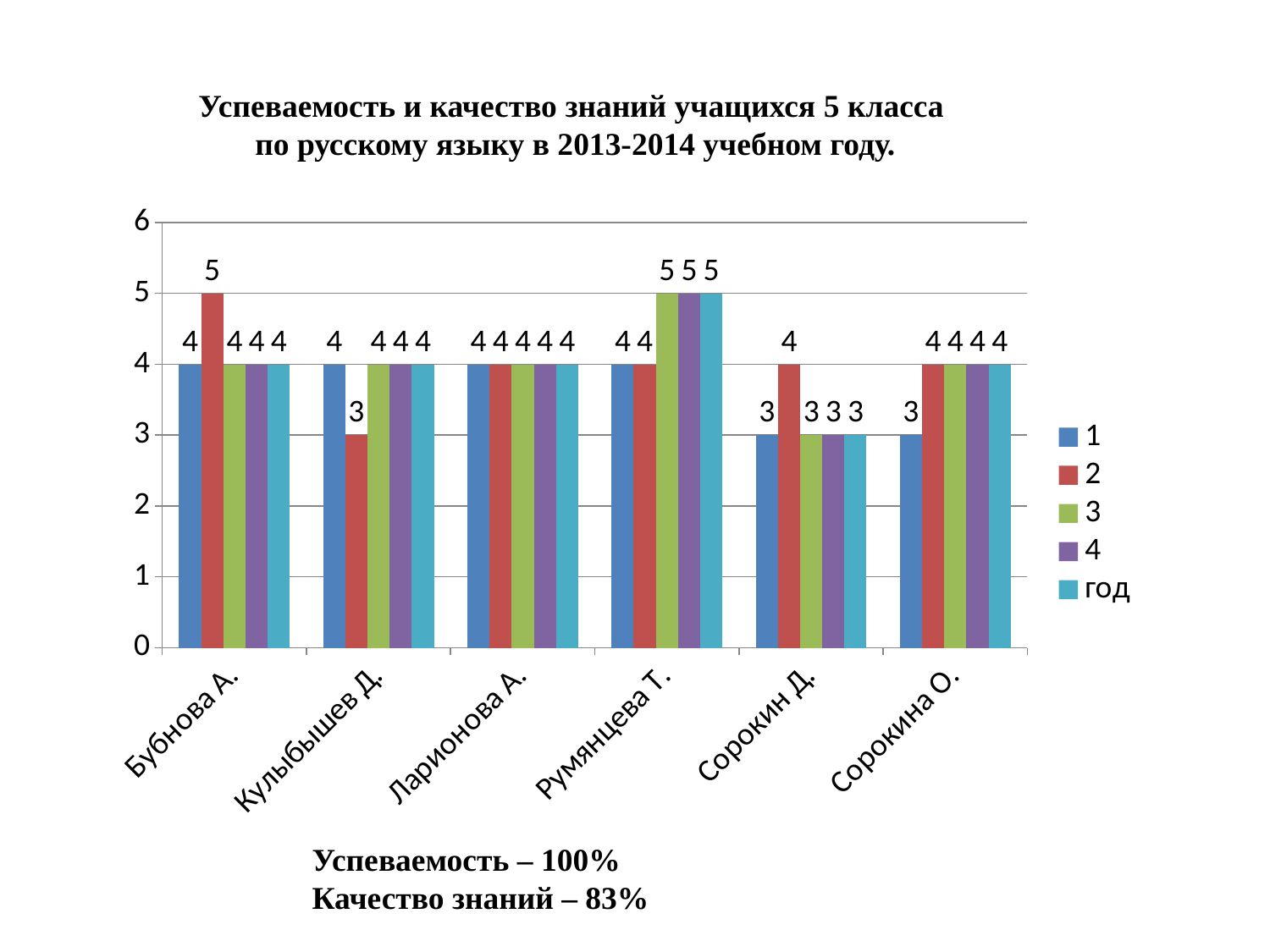
What is the difference between the series 2 values for Бубнова А. and Кулыбышев Д.? 2 Which student has the highest value in the series год? Румянцева Т. How many series does the legend list? 5 What is the value for Кулыбышев Д. in series 2? 3 What is the value for Сорокин Д. in series 1? 3 What type of chart is shown on the slide? bar chart Which is larger: the series 3 value for Румянцева Т. or the series 3 value for Сорокин Д.? Румянцева Т. What is the value for Румянцева Т. in the series год? 5 Which student has the lowest value in the series год? Сорокин Д. How many students (categories) are shown on the x axis? 6 What is the value for Бубнова А. in series 2? 5 What is the last entry in the legend? год